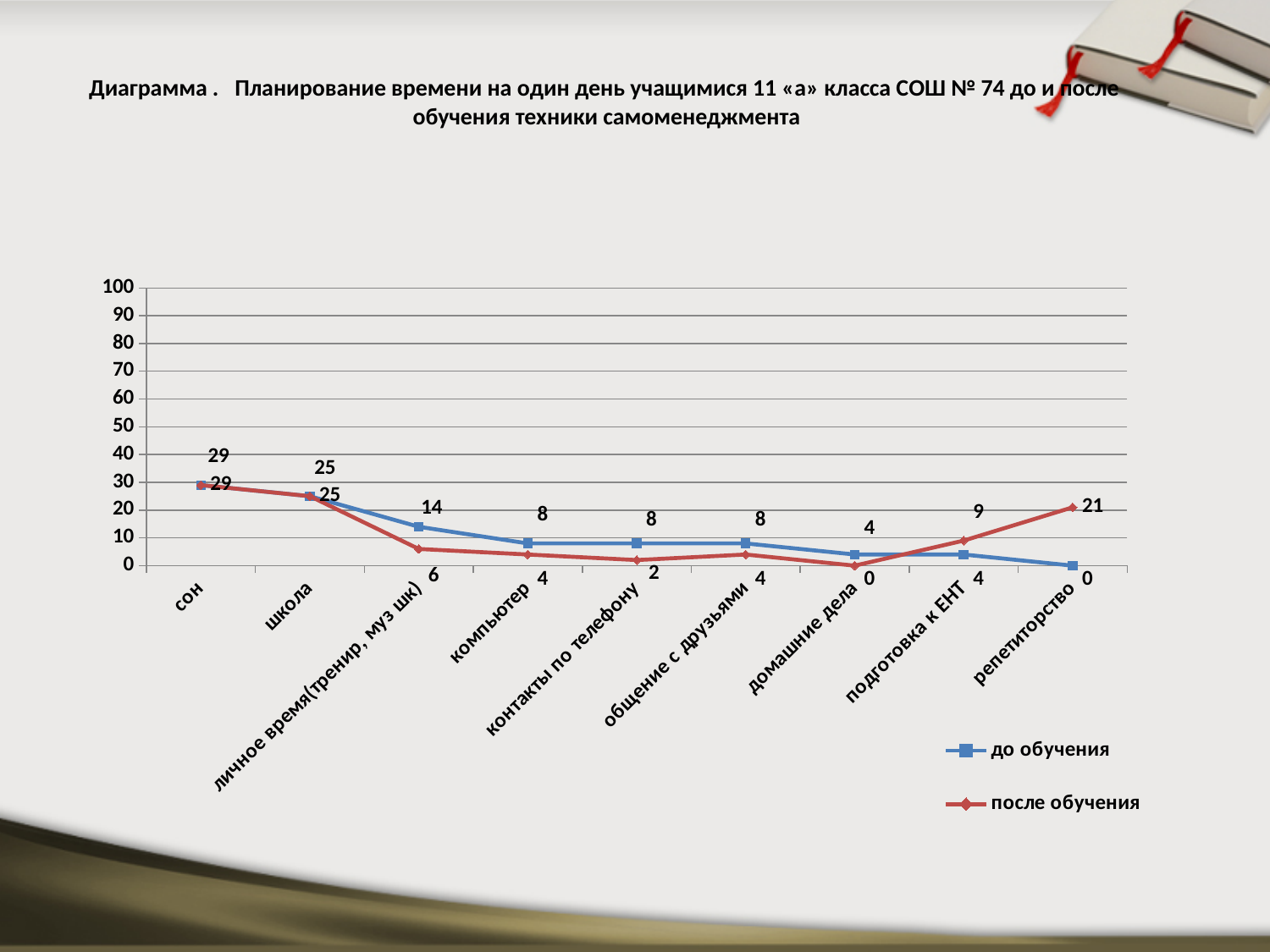
How many categories are plotted along the x axis? 9 What is the value for "репетиторство" in the "после обучения" series? 21 How many series does the legend list? 2 What is the difference between the "до обучения" and "после обучения" values for "личное время(тренир, муз шк)"? 8 Which series is drawn in red? после обучения Which category has the lowest value in the "после обучения" series? домашние дела For "подготовка к ЕНТ", which series has the larger value, "до обучения" or "после обучения"? после обучения What is the value for "компьютер" in the "до обучения" series? 8 Which category has the highest value in the "до обучения" series? сон What is the value for "личное время(тренир, муз шк)" in the "после обучения" series? 6 What kind of chart is shown on the slide? line chart Does the "до обучения" series generally rise or fall from "сон" to "репетиторство"? fall